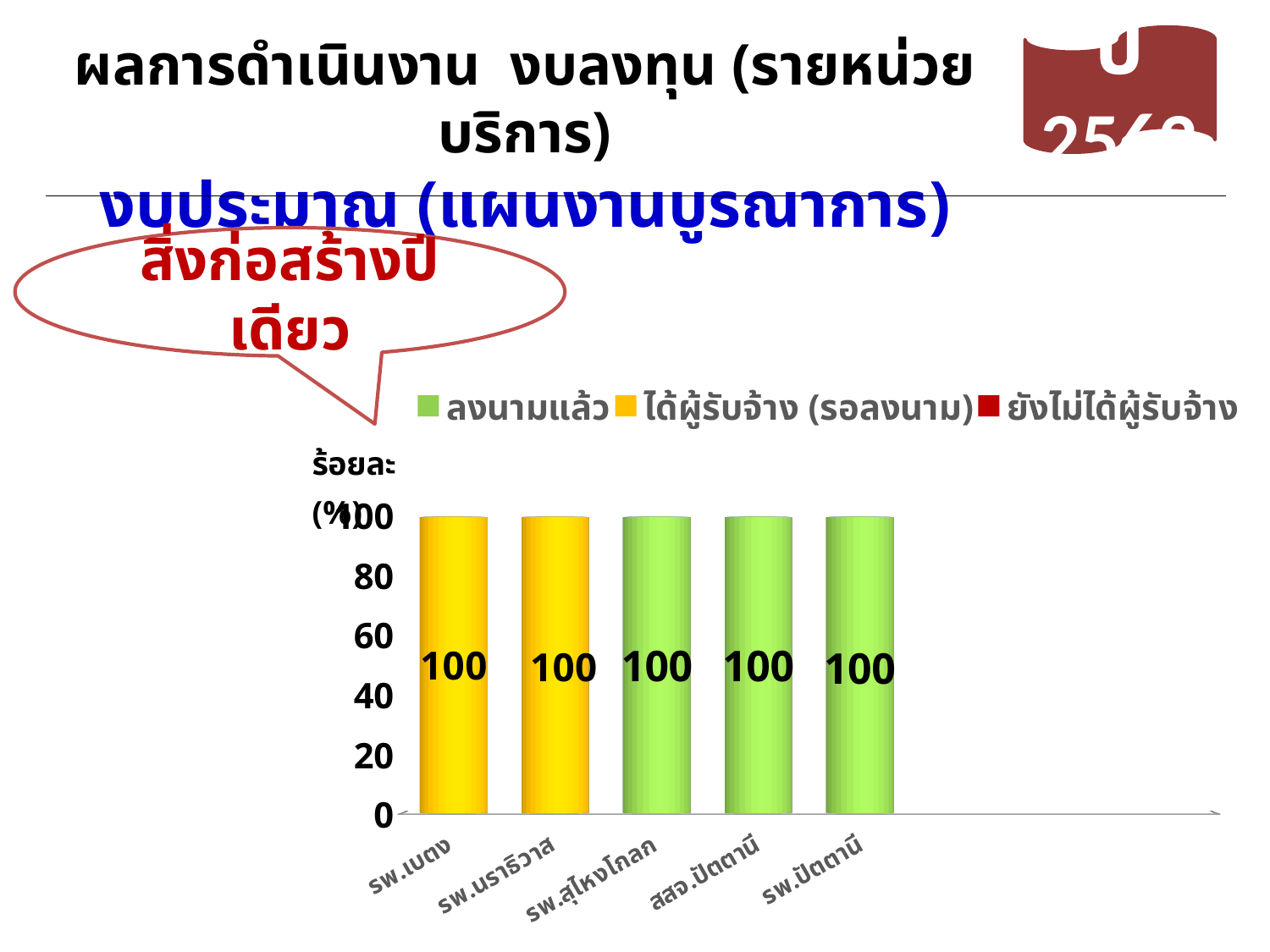
What is the value shown for รพ.สุไหงโกลก? 100 Which legend series is shown in green? ลงนามแล้ว What is the value shown for รพ.นราธิวาส? 100 Which legend series do the yellow bars for รพ.เบตง and รพ.นราธิวาส belong to? ได้ผู้รับจ้าง (รอลงนาม) What is the value shown for รพ.ปัตตานี? 100 What is the value shown for สสจ.ปัตตานี? 100 What is the value shown for รพ.เบตง? 100 Is the value for รพ.ปัตตานี greater or less than 80? greater How many categories are plotted on the x axis of the chart? 5 How many series does the chart legend list? 3 What is the difference between the values for รพ.เบตง and รพ.ปัตตานี? 0 What kind of chart is shown on the slide? bar chart